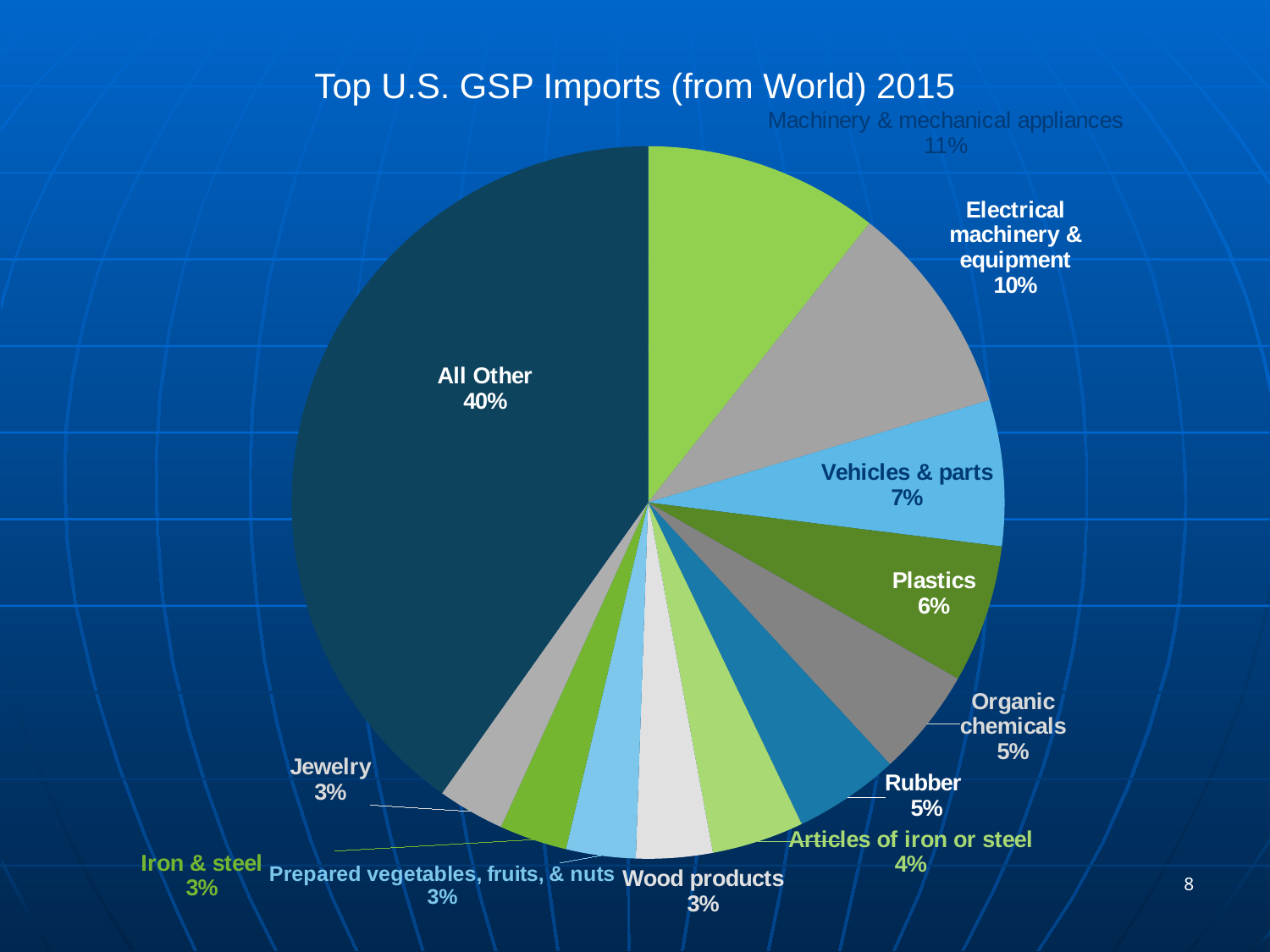
What is the value shown for Machinery & mechanical appliances? 11% What is the difference between the shares of All Other and Plastics? 34% How many slices does the pie chart have? 12 What share of the pie does All Other account for? 40% Which category has the largest slice of the pie? All Other What kind of chart is shown on the slide? Pie chart What is the value shown for Vehicles & parts? 7% What is the value shown for Electrical machinery & equipment? 10% What is the title of the chart? Top U.S. GSP Imports (from World) 2015 Which is larger, Plastics or Vehicles & parts? Vehicles & parts What is the difference between the shares of Machinery & mechanical appliances and Electrical machinery & equipment? 1% What is the value shown for Articles of iron or steel? 4%